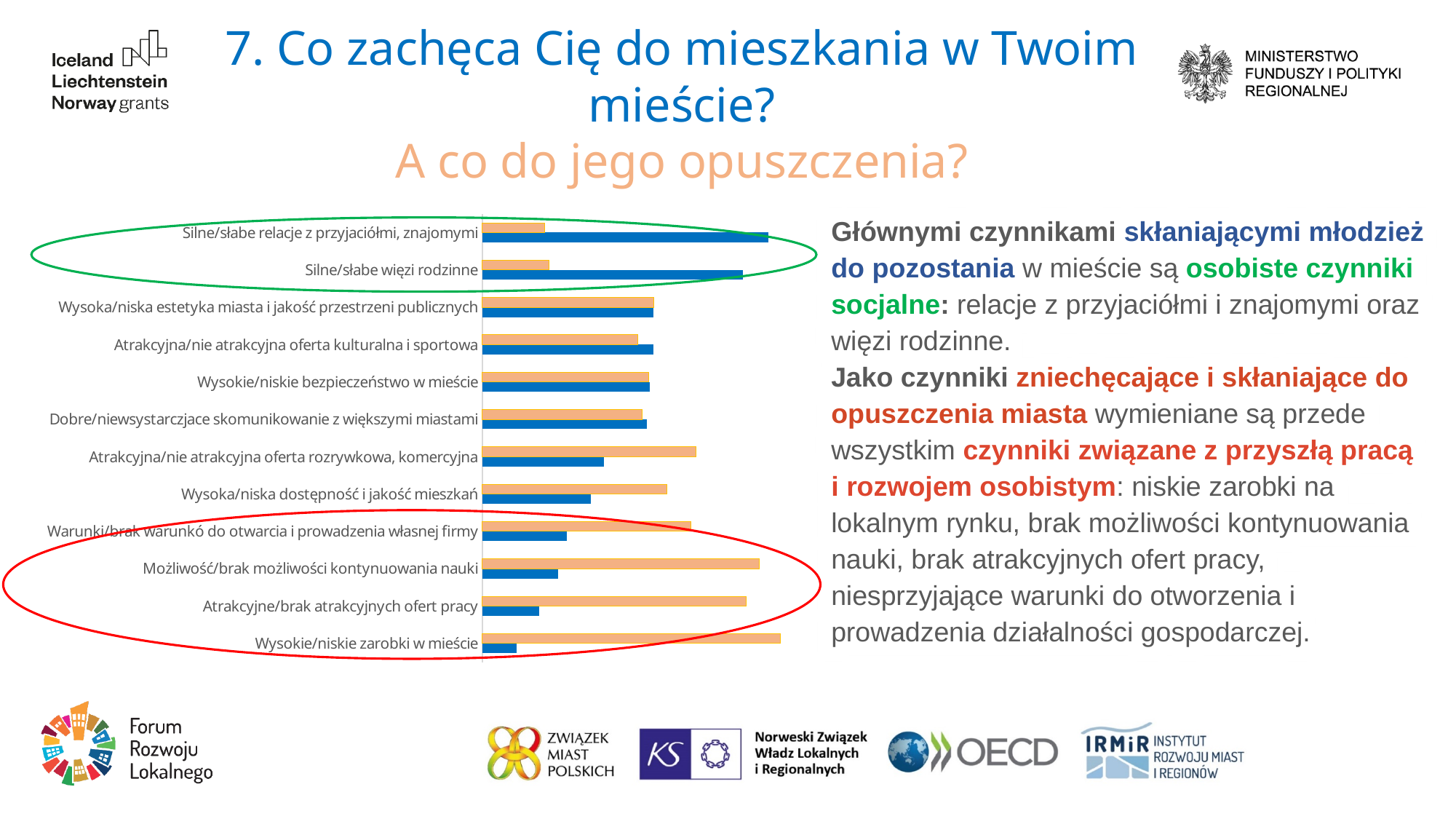
How many categories are listed on the chart's vertical axis? 12 Which category has the longest blue bar? Silne/słabe relacje z przyjaciółmi, znajomymi Which two categories on the chart are circled in green? Silne/słabe relacje z przyjaciółmi, znajomymi and Silne/słabe więzi rodzinne For "Silne/słabe relacje z przyjaciółmi, znajomymi", which bar is longer, the blue one or the orange one? blue Which category has the shortest blue bar? Wysokie/niskie zarobki w mieście For "Wysokie/niskie zarobki w mieście", which bar is longer, the blue one or the orange one? orange For "Atrakcyjna/nie atrakcyjna oferta rozrywkowa, komercyjna", which bar is longer, the blue one or the orange one? orange How many bars are plotted for each category on the chart? 2 What kind of chart is shown on the slide? bar chart What two colours are used for the bars in the chart? blue and orange